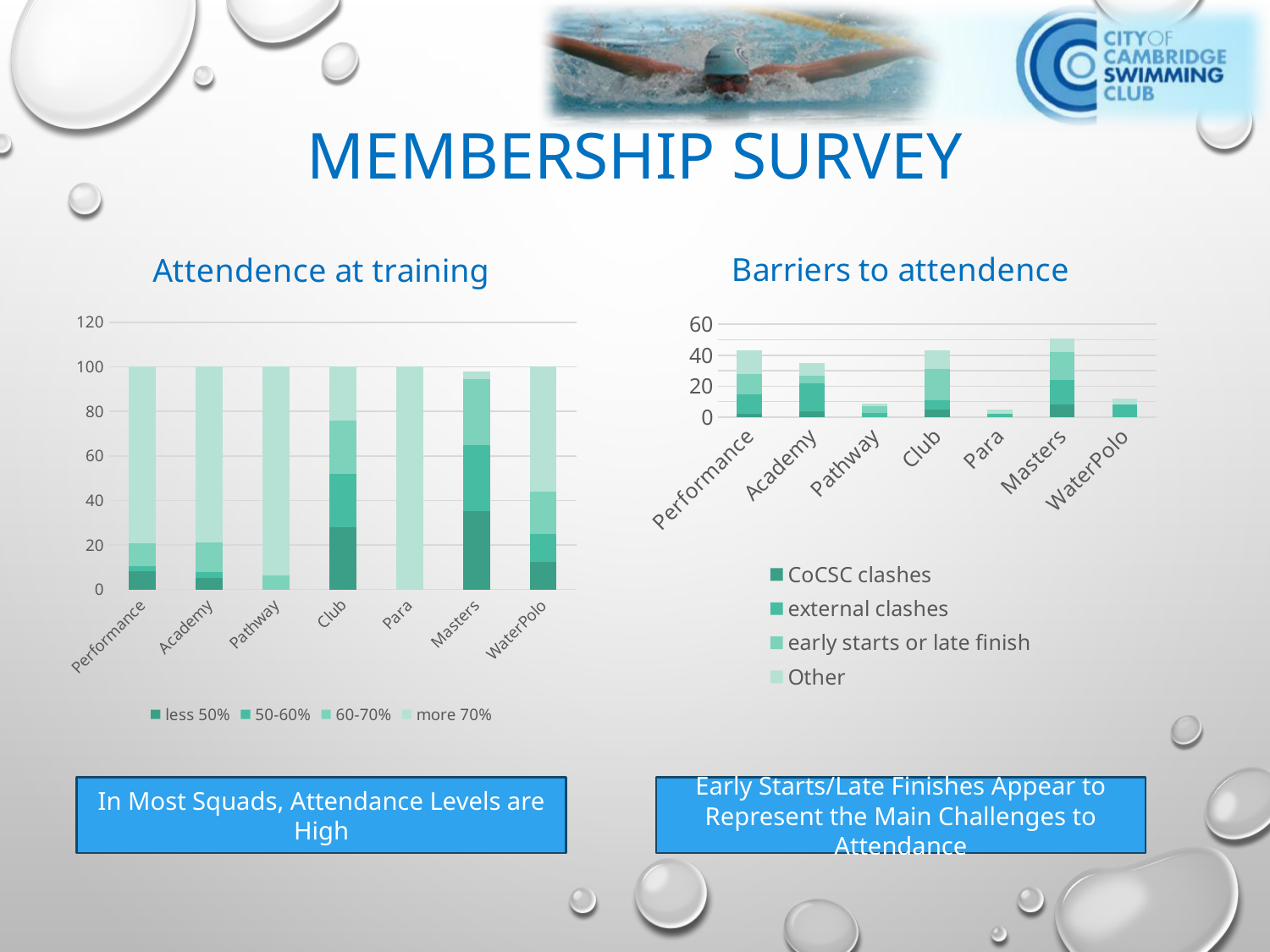
In the "Barriers to attendence" chart, which has the larger total bar, Performance or Academy? Performance What kind of chart is the "Attendence at training" chart? Stacked bar chart In the "Attendence at training" chart, is the "less 50%" value for Masters greater or less than 20? greater In the "Barriers to attendence" chart, is the total for Masters greater or less than 40? greater What are the legend entries of the "Barriers to attendence" chart? CoCSC clashes, external clashes, early starts or late finish, Other How many categories are shown on the x axis of the "Barriers to attendence" chart? 7 In the "Attendence at training" chart, is the "60-70%" value for Pathway greater or less than 20? less In the "Barriers to attendence" chart, which category has the lowest total bar? Para What is the title of the chart on the left of the slide? Attendence at training How many series does the legend of the "Attendence at training" chart list? 4 In the "Barriers to attendence" chart, which category has the highest total bar? Masters